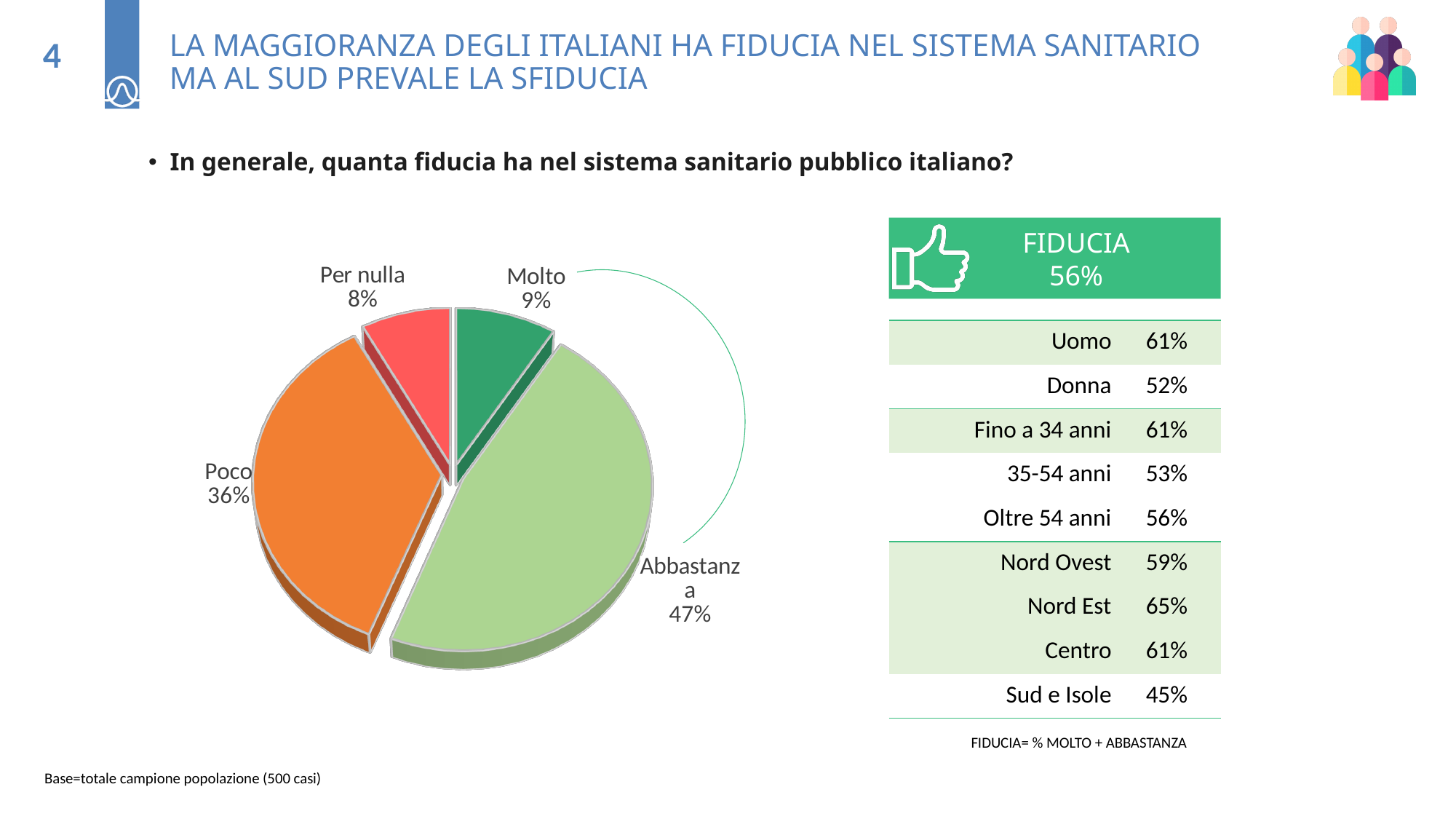
What type of chart is shown on the slide? pie chart Which is larger in the pie chart, 'Poco' or 'Molto'? Poco What is the value of the 'Abbastanza' slice in the pie chart? 47% How many slices does the pie chart have? 4 What is the combined share of the 'Molto' and 'Abbastanza' slices in the pie chart? 56% What is the difference between the 'Abbastanza' and 'Poco' slices in the pie chart? 11% Which slice of the pie chart is the smallest? Per nulla What is the value of the 'Poco' slice in the pie chart? 36% Which slice of the pie chart is the largest? Abbastanza What is the value of the 'Molto' slice in the pie chart? 9% What colour is the 'Poco' slice in the pie chart? orange What is the value of the 'Per nulla' slice in the pie chart? 8%